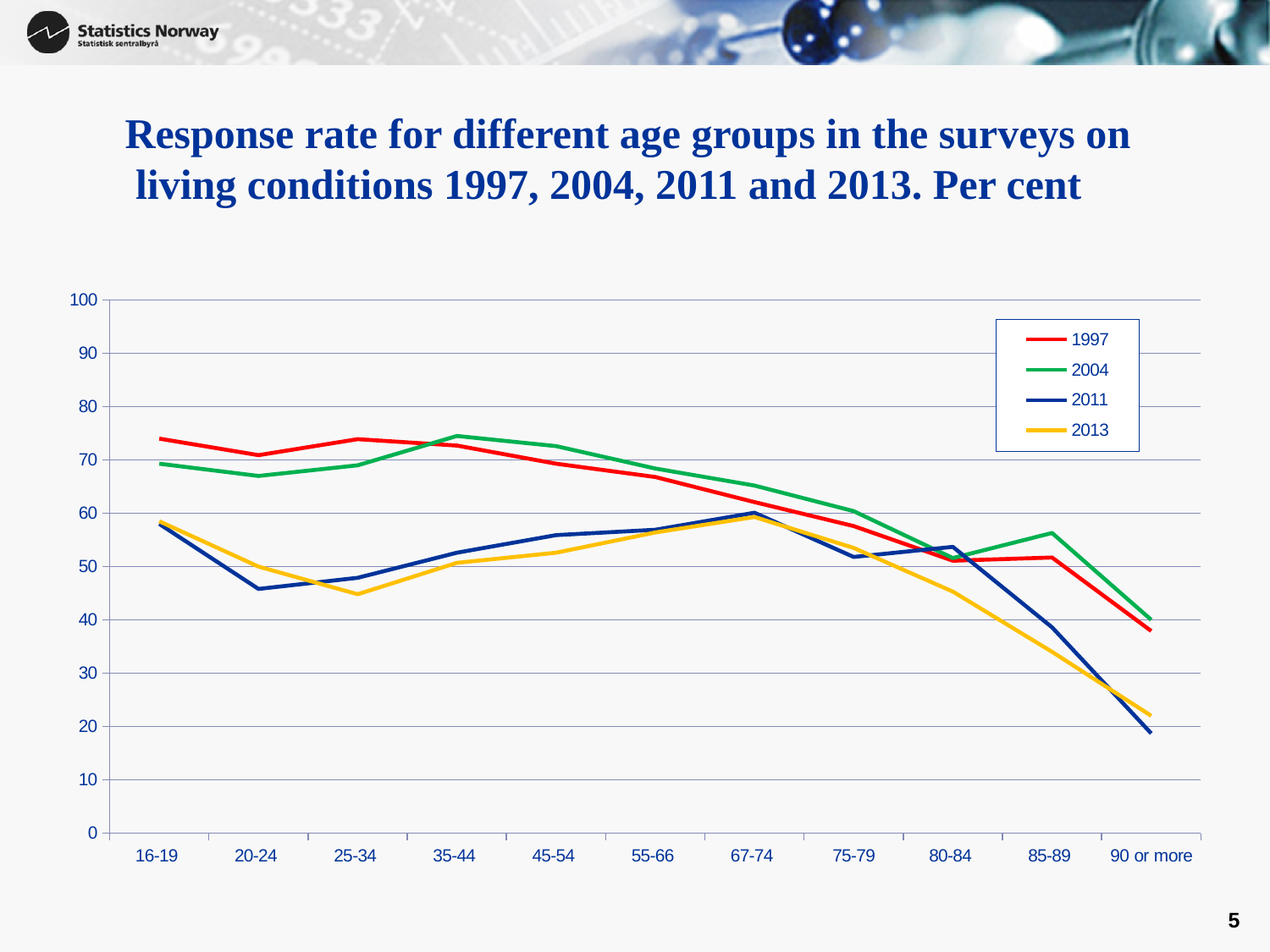
Is the 1997 response rate for the 16-19 age group greater or less than 70? greater How many age groups are shown on the x axis? 11 For the 20-24 age group, which survey has the higher response rate, 1997 or 2011? 1997 Is the 2011 response rate for the 20-24 age group greater or less than 50? less For the 2011 survey, which age group has the lowest response rate? 90 or more Is the 2013 response rate for the 25-34 age group greater or less than 50? less What kind of chart is shown on the slide? Line chart For the 2004 survey, which age group has the highest response rate? 35-44 How many series does the legend list? 4 Does the 2013 response rate rise or fall from the 67-74 age group to the 90 or more age group? fall For the 80-84 age group, which survey has the higher response rate, 2011 or 2013? 2011